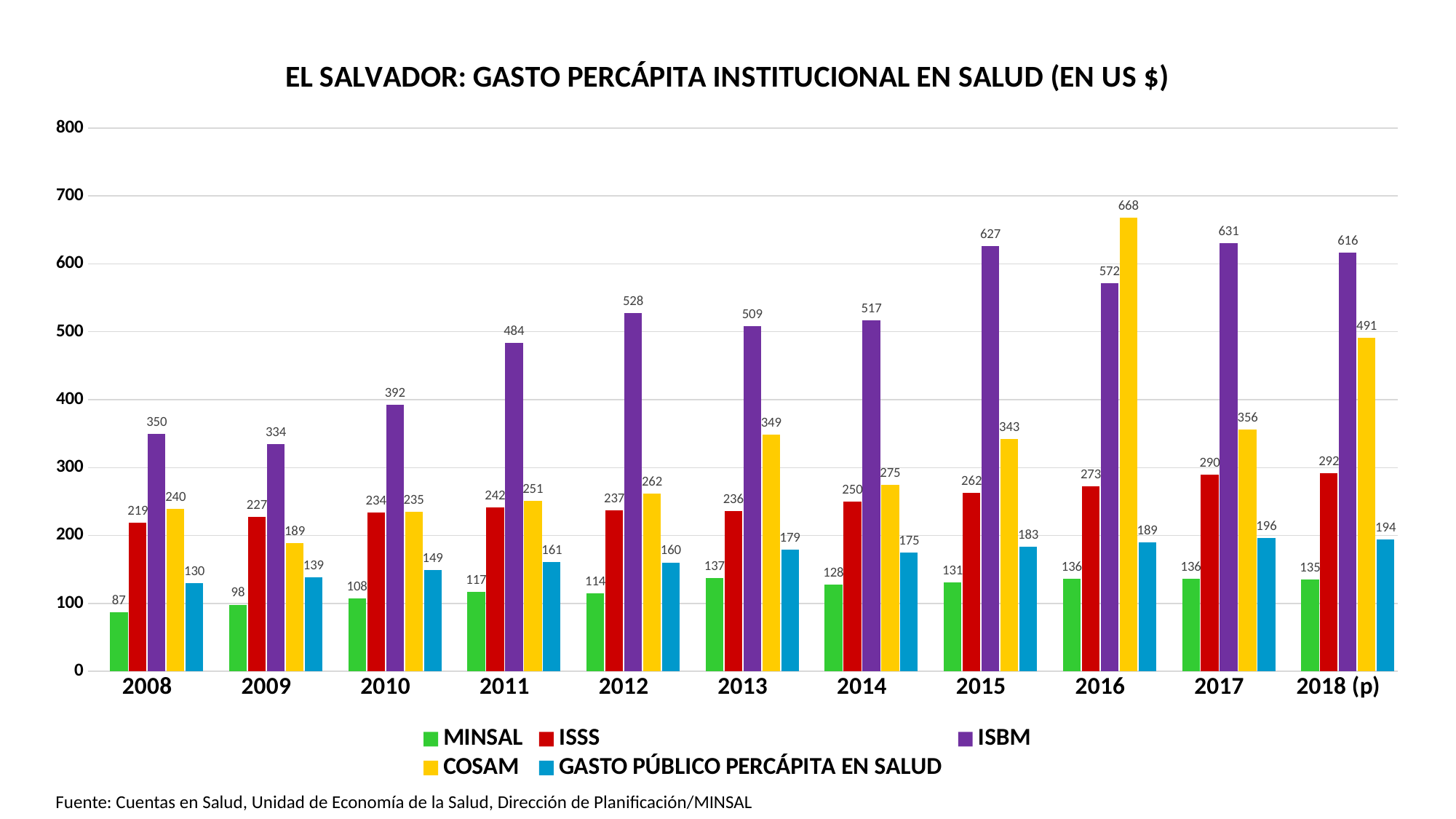
In which year is the COSAM value lowest? 2009 What is the value for MINSAL in 2008? 87 How many series does the legend list? 5 What is the value for GASTO PÚBLICO PERCÁPITA EN SALUD in 2017? 196 In which year is the ISBM value highest? 2017 How many years are shown on the x axis? 11 Is the value for ISBM in 2012 greater or less than 500? greater In 2016, which is larger: ISBM or COSAM? COSAM What kind of chart is shown on the slide? bar chart What is the value for COSAM in 2016? 668 What is the value for ISBM in 2015? 627 What is the difference between the ISSS value in 2018 (p) and in 2008? 73